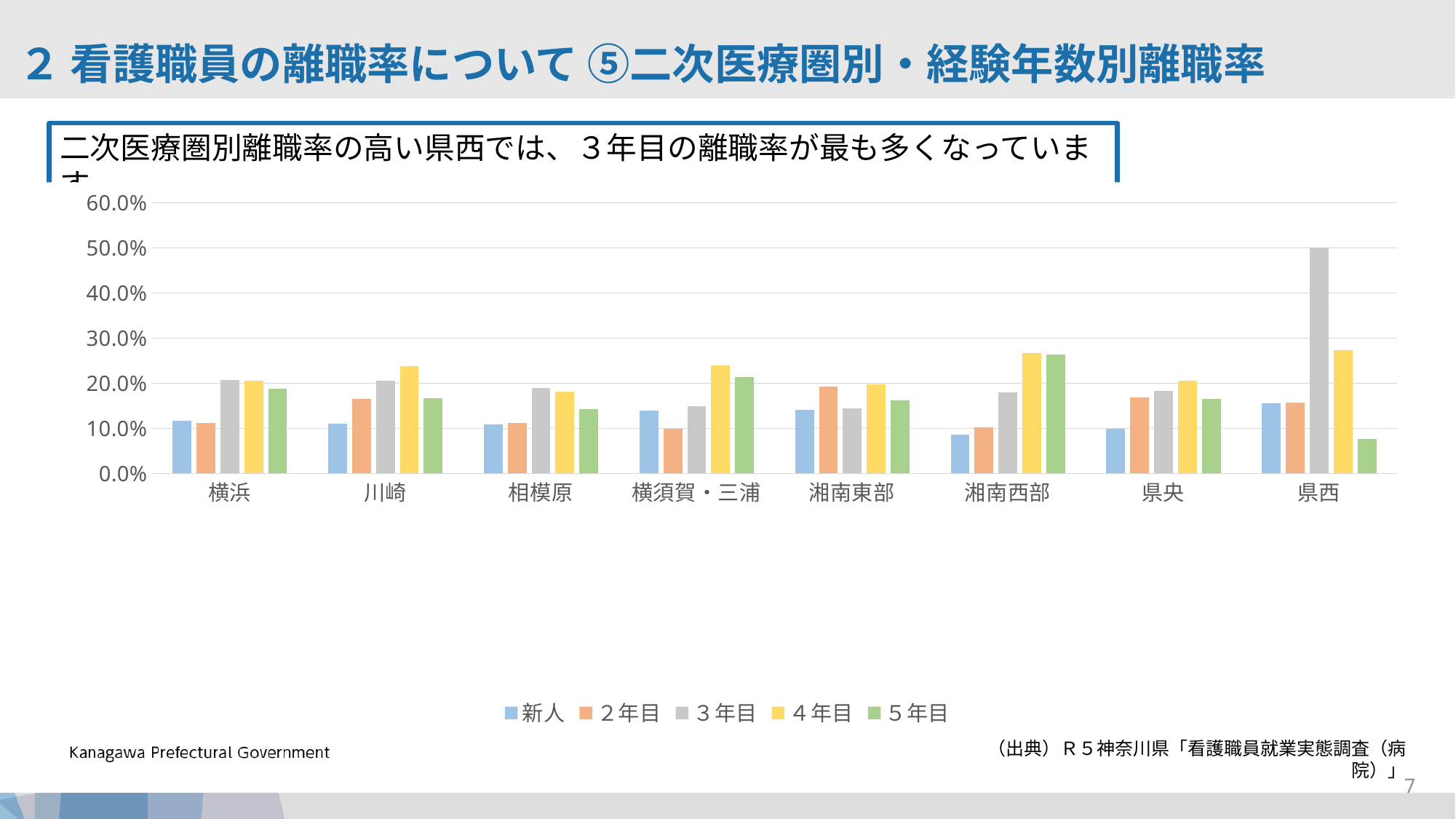
How many series does the legend list? 5 In 横須賀・三浦, which is larger, the value for 2年目 or the value for 4年目? 4年目 Which category and series has the highest bar in the chart? 県西, 3年目 Is the value for 4年目 in 湘南西部 greater or less than 20.0%? greater Is the value for 新人 in 湘南西部 greater or less than 10.0%? less Within 県西, which series has the lowest value? 5年目 Is the value for 3年目 in 県西 greater or less than 40.0%? greater What kind of chart is shown on the slide? bar chart In 県西, which is larger, the value for 3年目 or the value for 5年目? 3年目 How many secondary medical areas (categories) are shown on the x axis? 8 Which colour represents the 3年目 series in the legend? gray